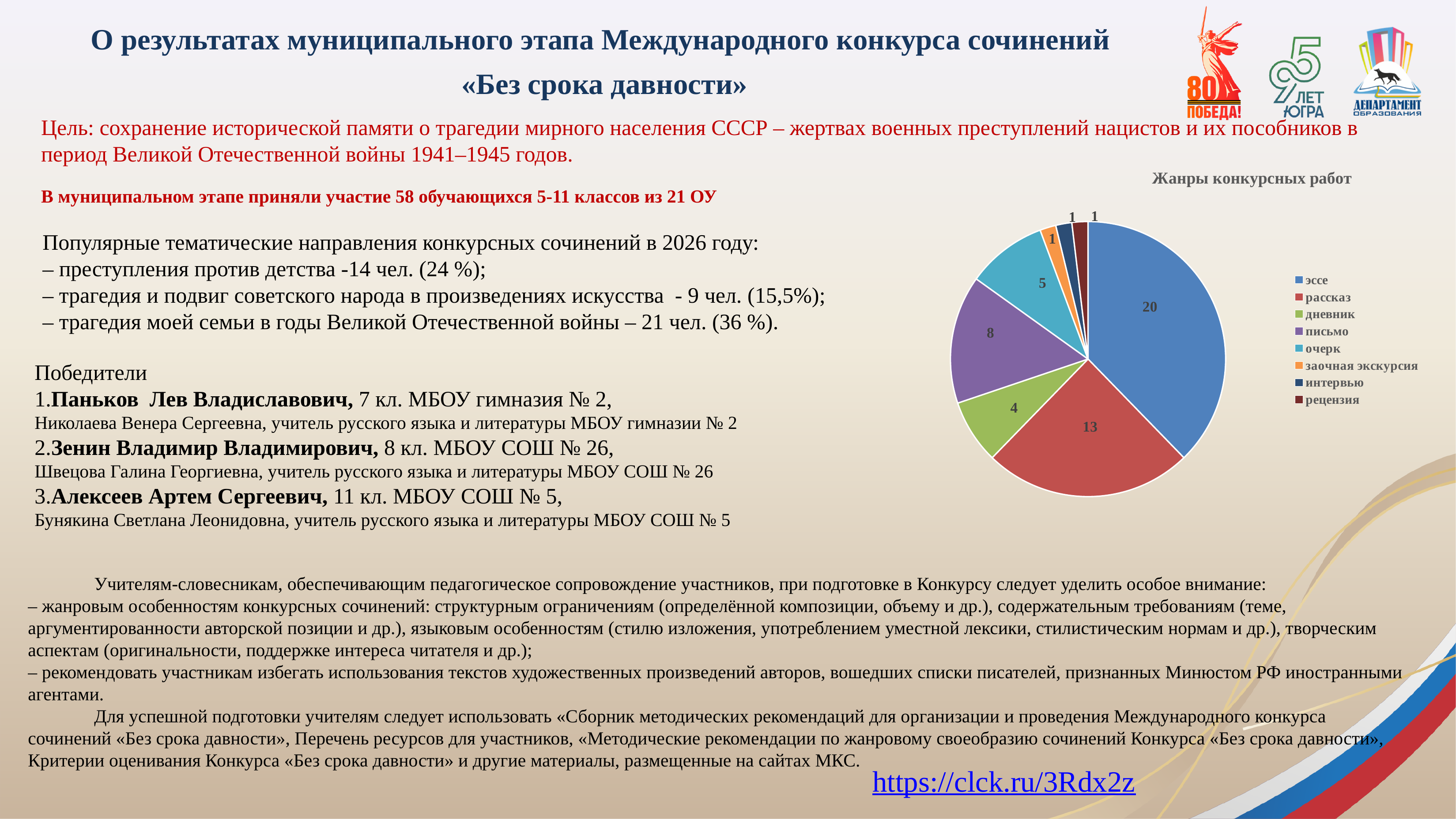
What is the difference between the values for эссе and рассказ? 7 Which is larger, the value for письмо or the value for очерк? письмо What type of chart is shown on the slide? pie chart How many entries does the chart legend list? 8 What is the value for очерк in the pie chart? 5 Which genre has the largest slice in the pie chart? эссе What is the value for эссе in the pie chart? 20 What is the title of the chart? Жанры конкурсных работ What is the value for рассказ in the pie chart? 13 What is the value for письмо in the pie chart? 8 How many categories does the pie chart show? 8 What is the value for дневник in the pie chart? 4